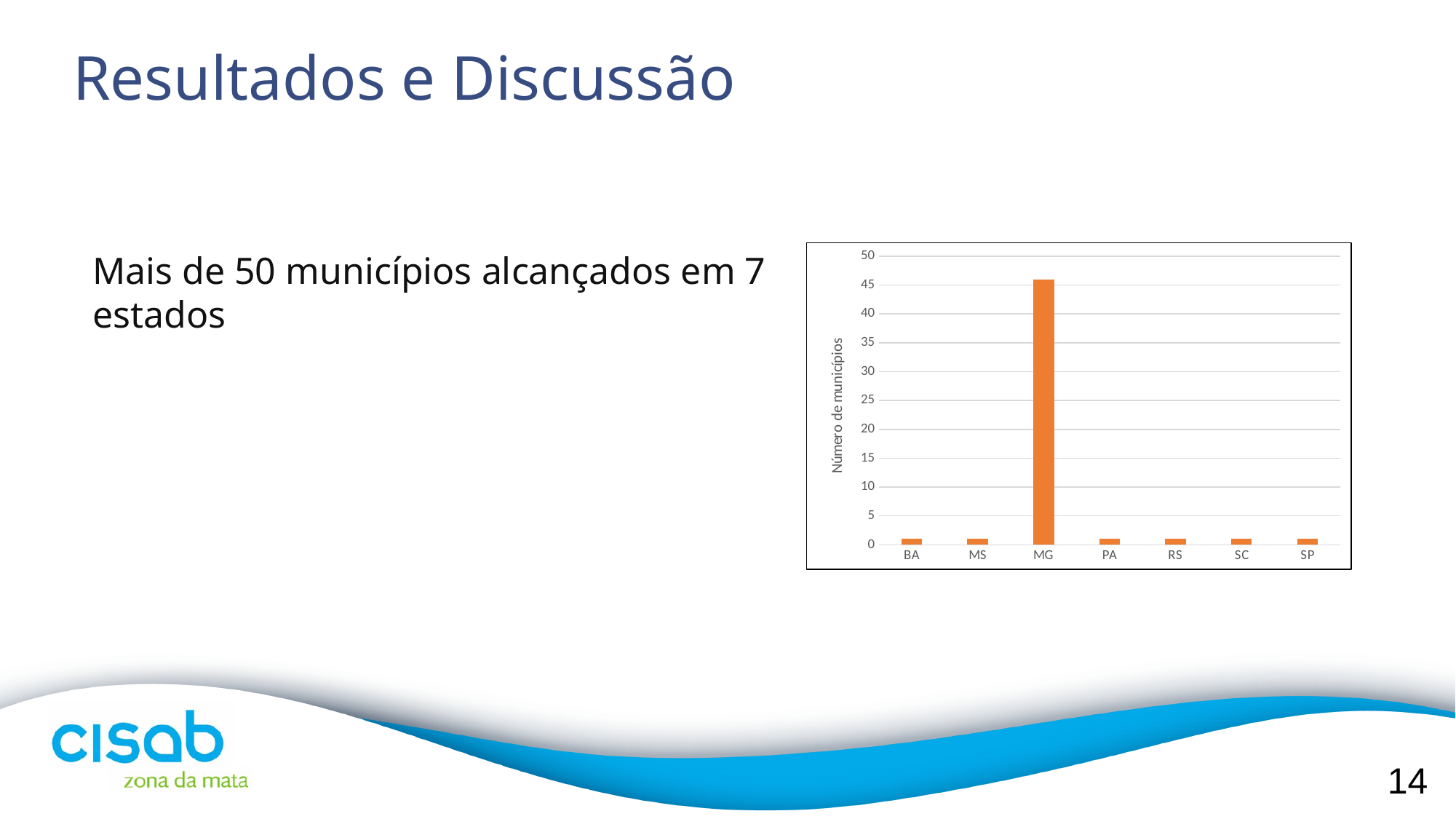
Which state has the highest number of municipalities in the chart? MG Which is larger, the value for RS or the value for MG? MG Which is larger, the value for MG or the value for PA? MG What kind of chart is shown on the slide? bar chart Is the value for MG greater or less than 50? less Is the value for SP greater or less than 10? less How many states (categories) are shown on the x axis of the chart? 7 What is the highest value shown on the vertical axis of the chart? 50 What is the label of the vertical axis of the chart? Número de municípios Is the value for BA greater or less than 5? less What colour are the bars in the chart? orange